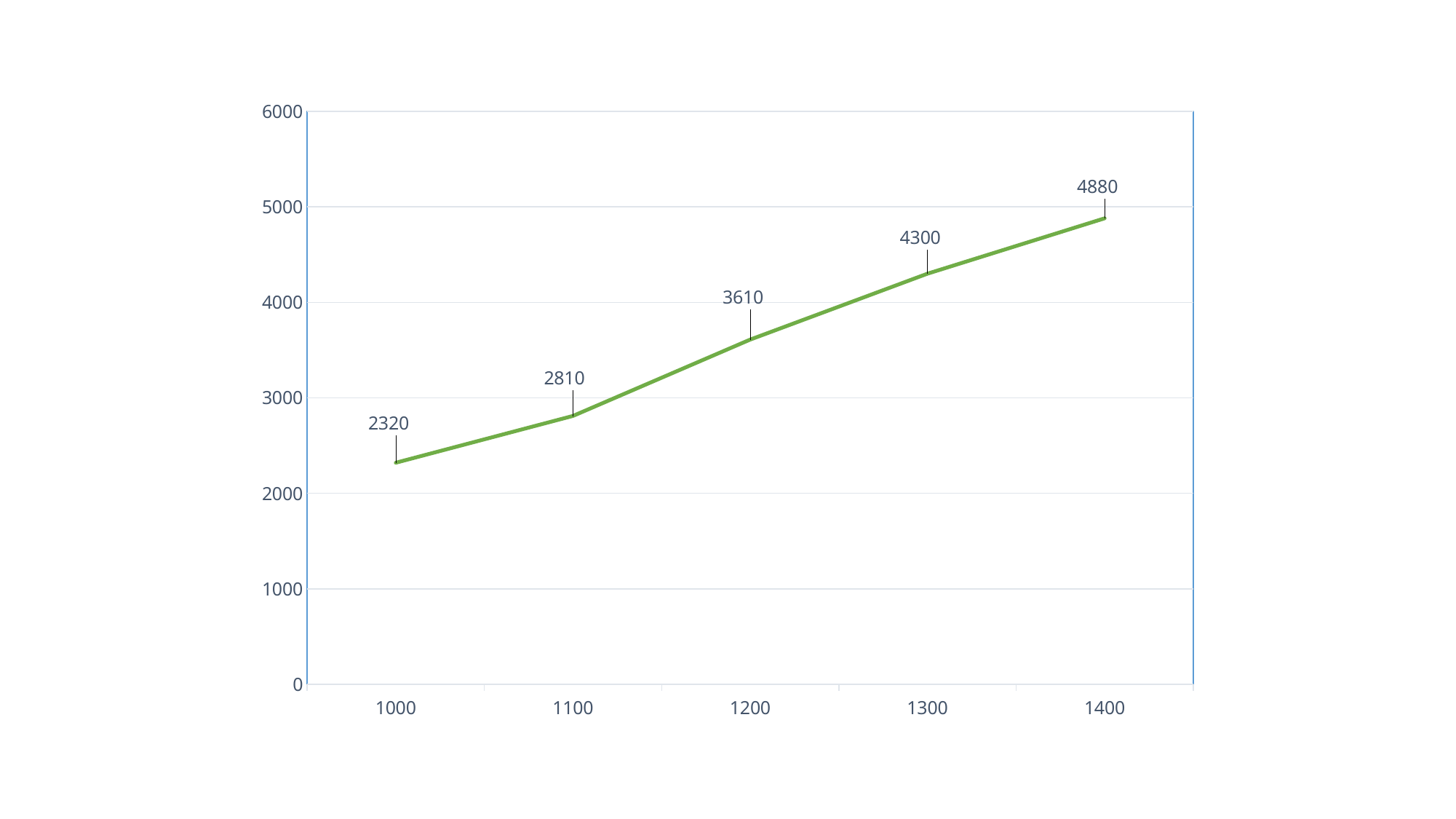
What is the value at x = 1400? 4880 What is the value at x = 1200? 3610 How many data points are plotted on the line? 5 Do the values rise or fall as x increases from 1000 to 1400? rise At which x value is the plotted value highest? 1400 What is the difference between the values at x = 1400 and x = 1300? 580 What is the difference between the values at x = 1300 and x = 1100? 1490 At which x value is the plotted value lowest? 1000 What is the value at x = 1000? 2320 Which is larger, the value at x = 1100 or the value at x = 1200? 1200 Is the value at x = 1300 greater or less than 4000? greater What type of chart is shown on the slide? line chart